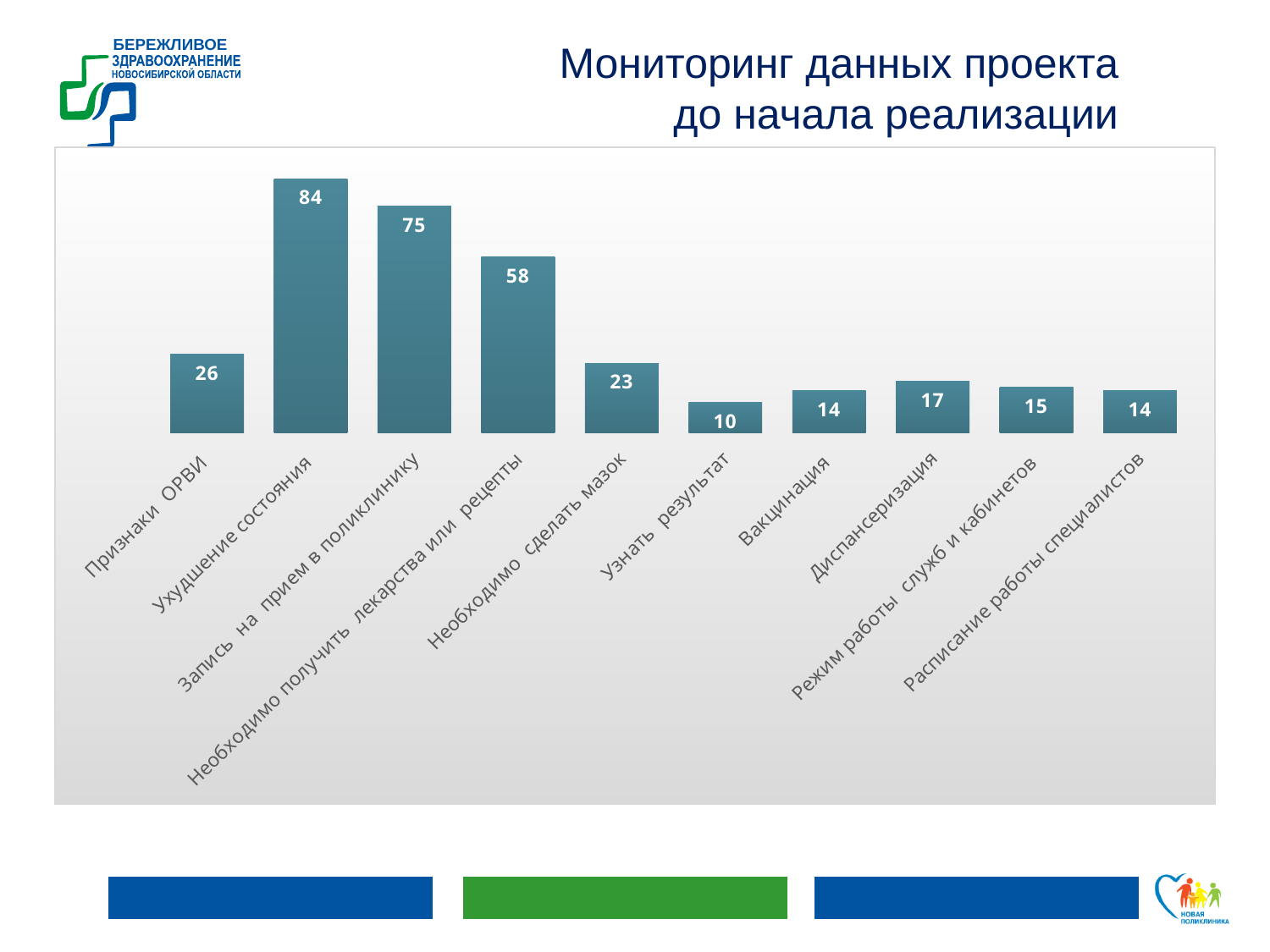
What is the value for «Запись на прием в поликлинику»? 75 What is the difference between the values for «Необходимо получить лекарства или рецепты» and «Признаки ОРВИ»? 32 Which is larger, the value for «Признаки ОРВИ» or the value for «Необходимо сделать мазок»? Признаки ОРВИ What is the value for «Ухудшение состояния»? 84 What kind of chart is shown on the slide? Bar chart How many categories are shown in the chart? 10 What is the title of the slide containing the chart? Мониторинг данных проекта до начала реализации Which category has the highest value? Ухудшение состояния What is the difference between the values for «Ухудшение состояния» and «Запись на прием в поликлинику»? 9 What is the value for «Диспансеризация»? 17 What is the value for «Вакцинация»? 14 Which category has the lowest value? Узнать результат